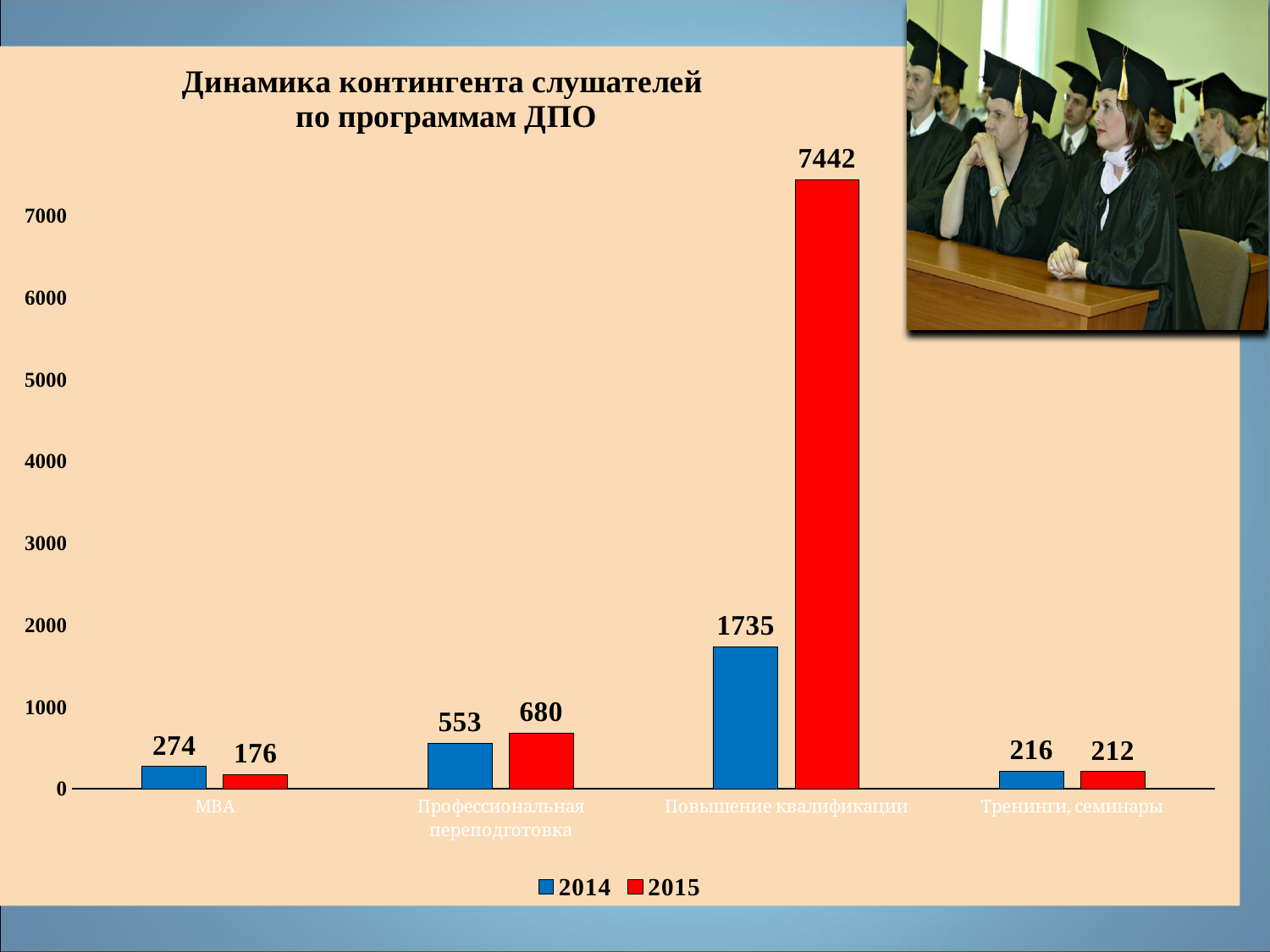
What is the value for 2014 in the MBA category? 274 Which category has the highest value for 2015? Повышение квалификации What is the value for 2014 in the Тренинги, семинары category? 216 What is the difference between the 2015 and 2014 values for Повышение квалификации? 5707 How many series does the legend list? 2 How many categories are shown on the x axis? 4 What type of chart is shown on the slide? Bar chart Which is larger for Профессиональная переподготовка, the 2014 value or the 2015 value? 2015 What is the value for 2015 in the Профессиональная переподготовка category? 680 What is the value for 2015 in the Повышение квалификации category? 7442 Which category has the lowest value for 2015? MBA What is the difference between the 2014 and 2015 values for MBA? 98